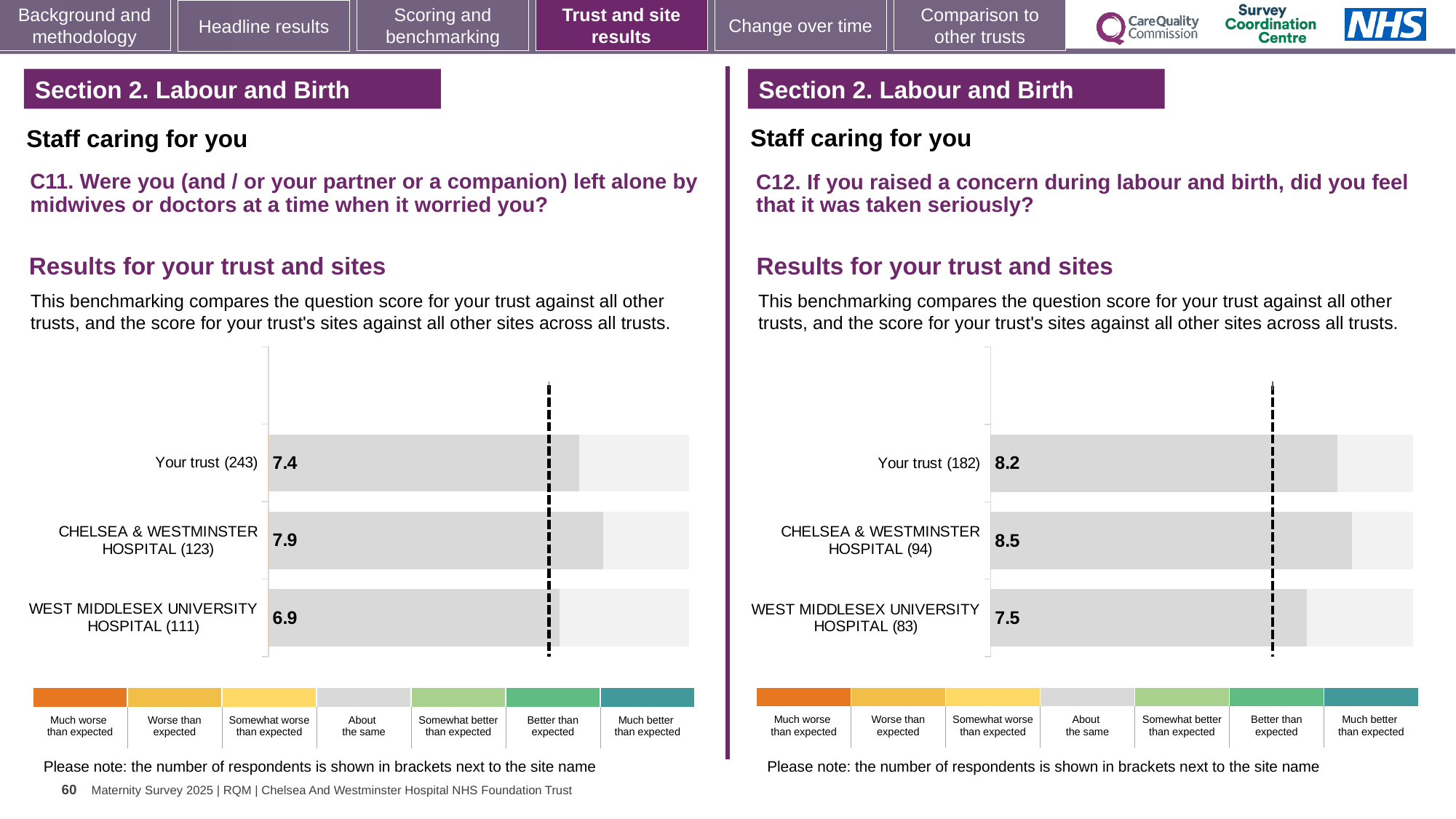
In the C11 chart on the left, what is the score for WEST MIDDLESEX UNIVERSITY HOSPITAL (111)? 6.9 In the C12 chart on the right, which site or trust has the lowest score? WEST MIDDLESEX UNIVERSITY HOSPITAL (83) In the C12 chart on the right, what is the score for WEST MIDDLESEX UNIVERSITY HOSPITAL (83)? 7.5 How many bars are shown in the C11 chart on the left? 3 In the C11 chart on the left, which site or trust has the lowest score? WEST MIDDLESEX UNIVERSITY HOSPITAL (111) In the C12 chart on the right, what is the score for CHELSEA & WESTMINSTER HOSPITAL (94)? 8.5 In the C11 chart on the left, what is the score for Your trust (243)? 7.4 In the C11 chart on the left, which site or trust has the highest score? CHELSEA & WESTMINSTER HOSPITAL (123) In the C11 chart on the left, what is the score for CHELSEA & WESTMINSTER HOSPITAL (123)? 7.9 In the C11 chart on the left, what is the difference between the scores for CHELSEA & WESTMINSTER HOSPITAL (123) and WEST MIDDLESEX UNIVERSITY HOSPITAL (111)? 1.0 In the C12 chart on the right, is the score for Your trust (182) larger or smaller than the score for CHELSEA & WESTMINSTER HOSPITAL (94)? smaller In the C12 chart on the right, what is the score for Your trust (182)? 8.2